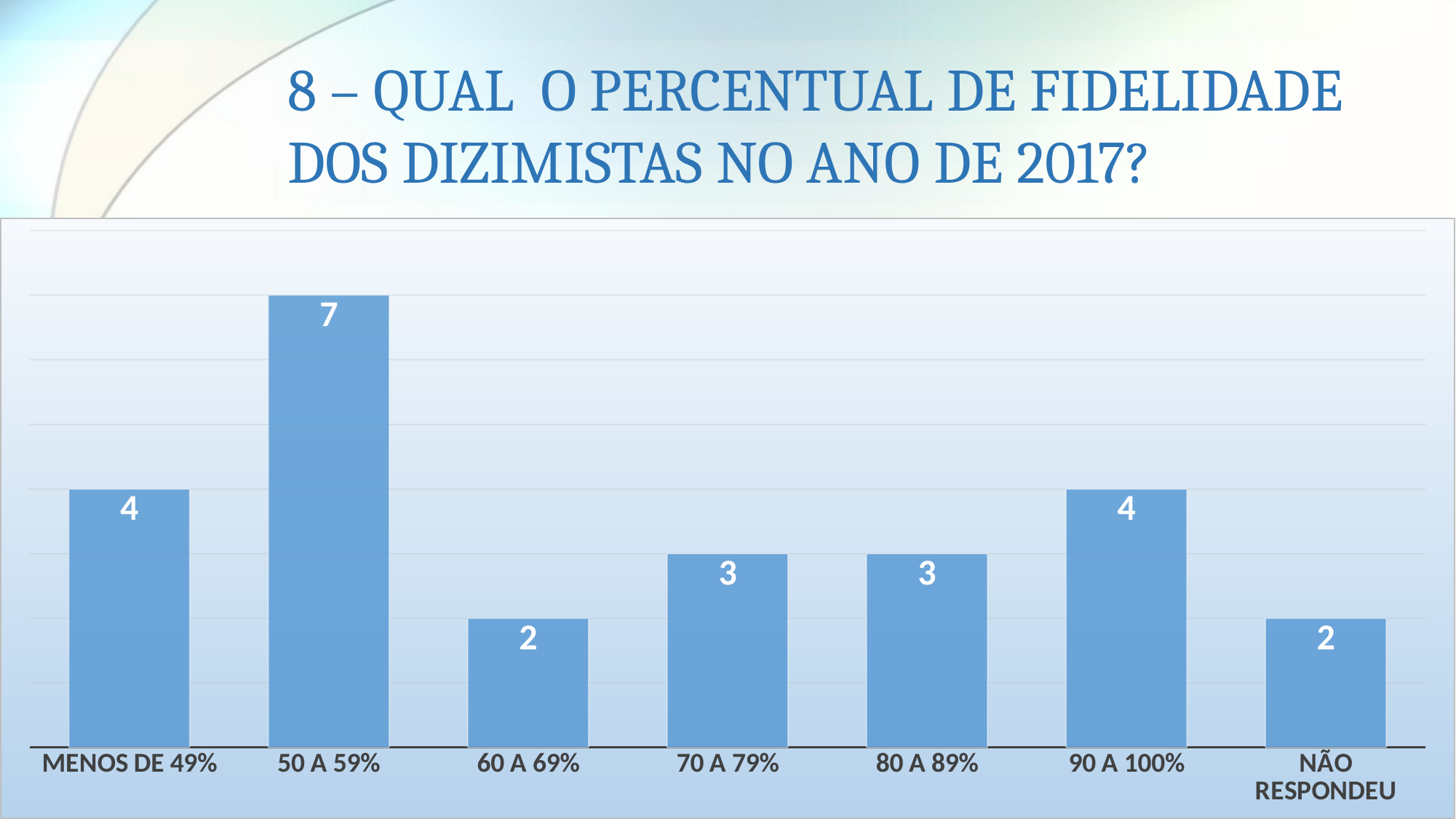
Which is larger, the value for '90 A 100%' or the value for '80 A 89%'? 90 A 100% What kind of chart is shown on the slide? bar chart What is the value for the 'NÃO RESPONDEU' category? 2 What is the difference between the values for '50 A 59%' and '60 A 69%'? 5 What is the value for the '50 A 59%' category? 7 What is the title of the slide containing the chart? 8 – QUAL O PERCENTUAL DE FIDELIDADE DOS DIZIMISTAS NO ANO DE 2017? What is the value for the '70 A 79%' category? 3 Which category has the highest value? 50 A 59% How many categories are shown on the x axis? 7 What is the difference between the values for 'MENOS DE 49%' and '70 A 79%'? 1 Which two categories both have a value of 3? 70 A 79% and 80 A 89% What is the value for the 'MENOS DE 49%' category? 4